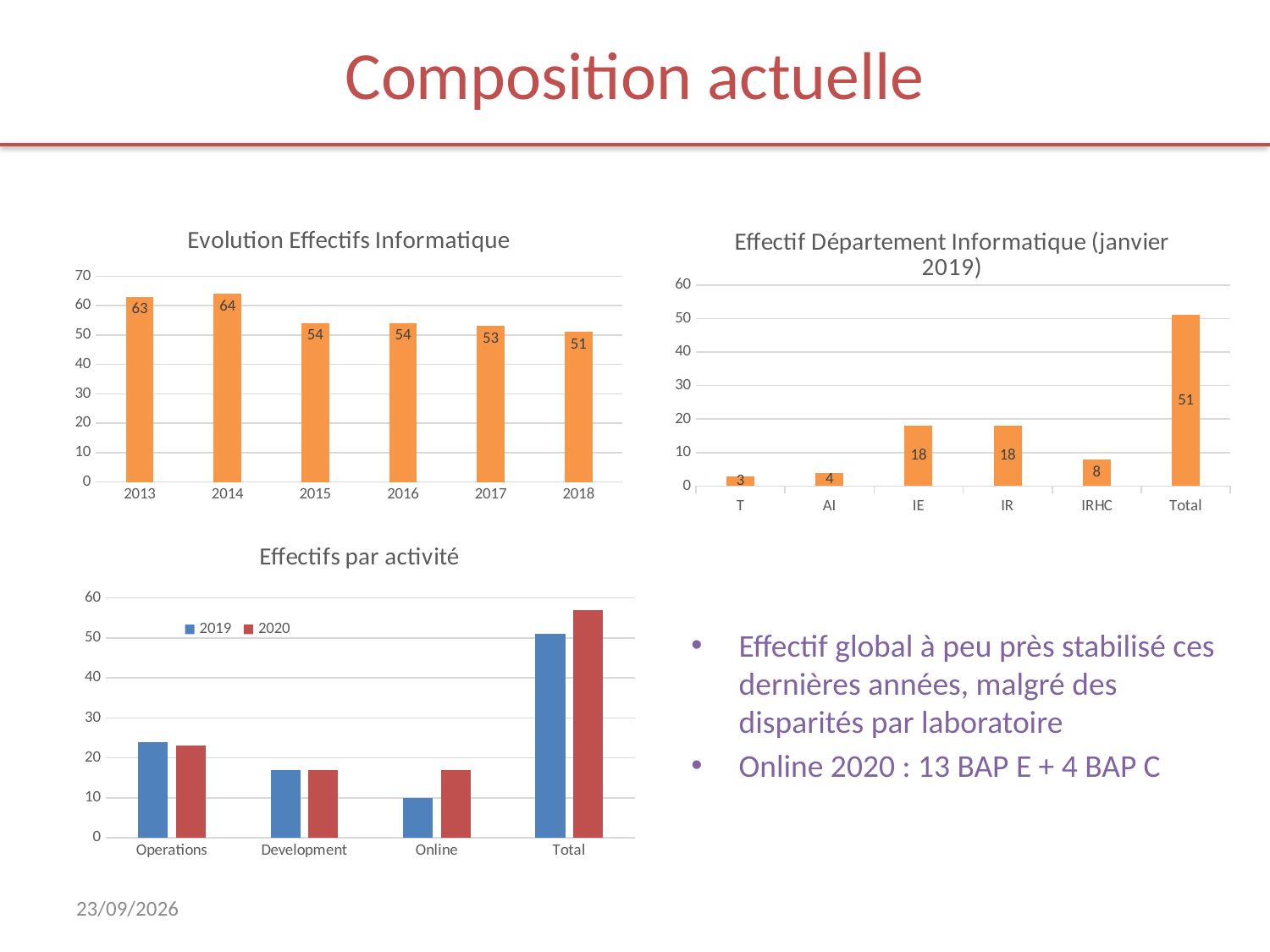
What kind of chart is 'Effectifs par activité'? bar chart In the 'Effectif Département Informatique (janvier 2019)' chart, which category has the lowest value? T In the 'Effectifs par activité' chart, which is larger for Online: the 2019 value or the 2020 value? 2020 How many series does the legend of the 'Effectifs par activité' chart list? 2 In the 'Effectifs par activité' chart, is the 2019 value for Online greater or less than 20? less In the 'Effectif Département Informatique (janvier 2019)' chart, what is the value for IRHC? 8 How many categories are shown on the x axis of the 'Effectif Département Informatique (janvier 2019)' chart? 6 In the 'Evolution Effectifs Informatique' chart, which year has the highest value? 2014 In the 'Evolution Effectifs Informatique' chart, which year has the lowest value? 2018 In the 'Evolution Effectifs Informatique' chart, what is the difference between the values for 2013 and 2018? 12 In the 'Evolution Effectifs Informatique' chart, do the values generally rise or fall from 2014 to 2018? fall In the 'Evolution Effectifs Informatique' chart, what is the value for 2014? 64